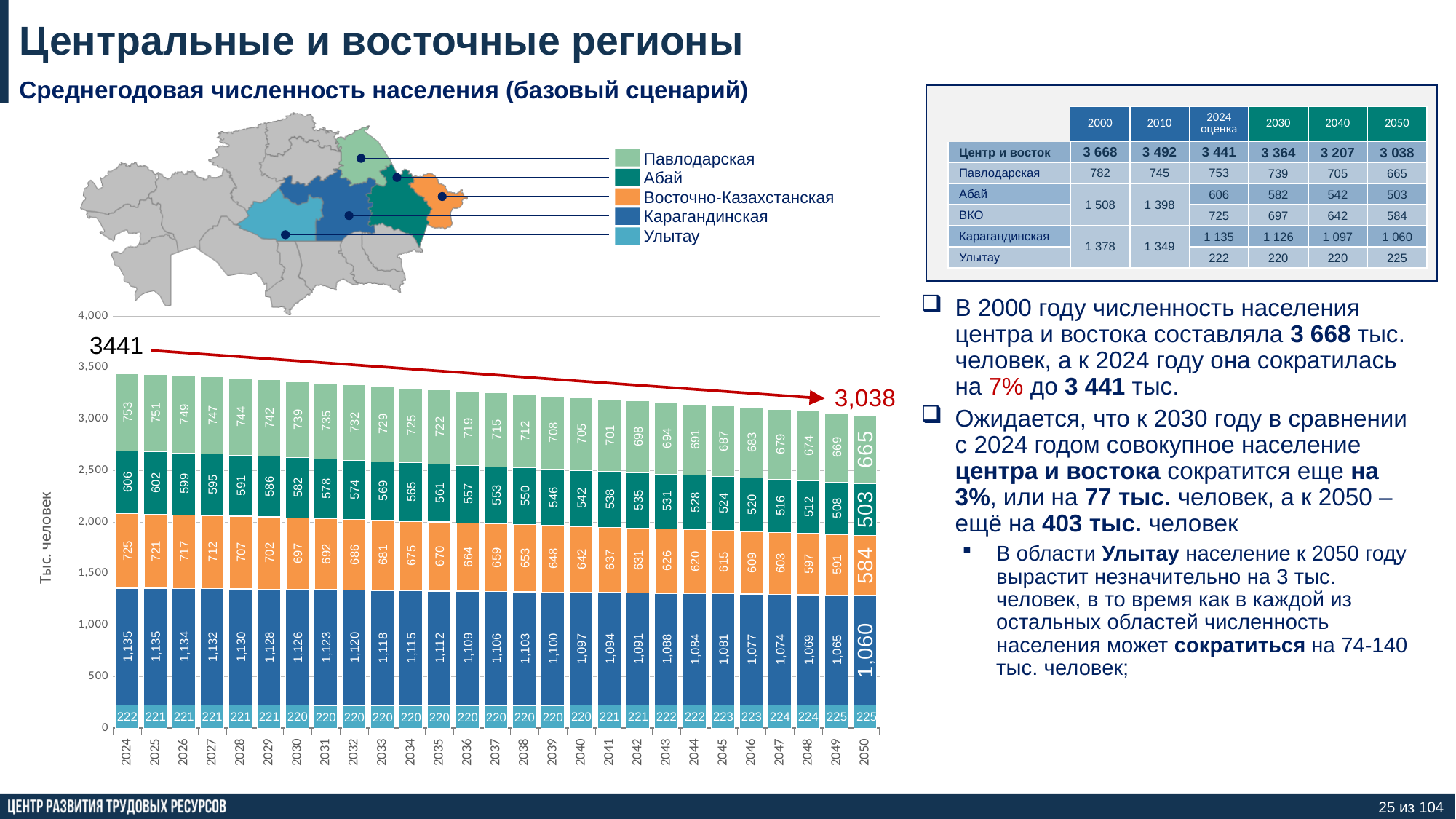
What is the value for Карагандинская in 2050 on the chart? 1,060 What is the value for Улытау in 2040 on the chart? 220 How many years (bars) are plotted on the x axis of the chart? 27 What kind of chart is shown on the slide? Stacked bar chart What is the value for Восточно-Казахстанская in 2030 on the chart? 697 How many regions (series) are stacked in each bar of the chart? 5 What is the value for Павлодарская in 2024 on the chart? 753 Do the total bar heights rise or fall from 2024 to 2050 on the chart? Fall Which region has the largest segment in the 2024 bar of the chart? Карагандинская What is the total of the stacked bar for 2050 on the chart? 3,038 Is the total for 2040 on the chart greater or less than 3,000? greater By how much does the value for Абай decrease from 2024 to 2050 on the chart? 103